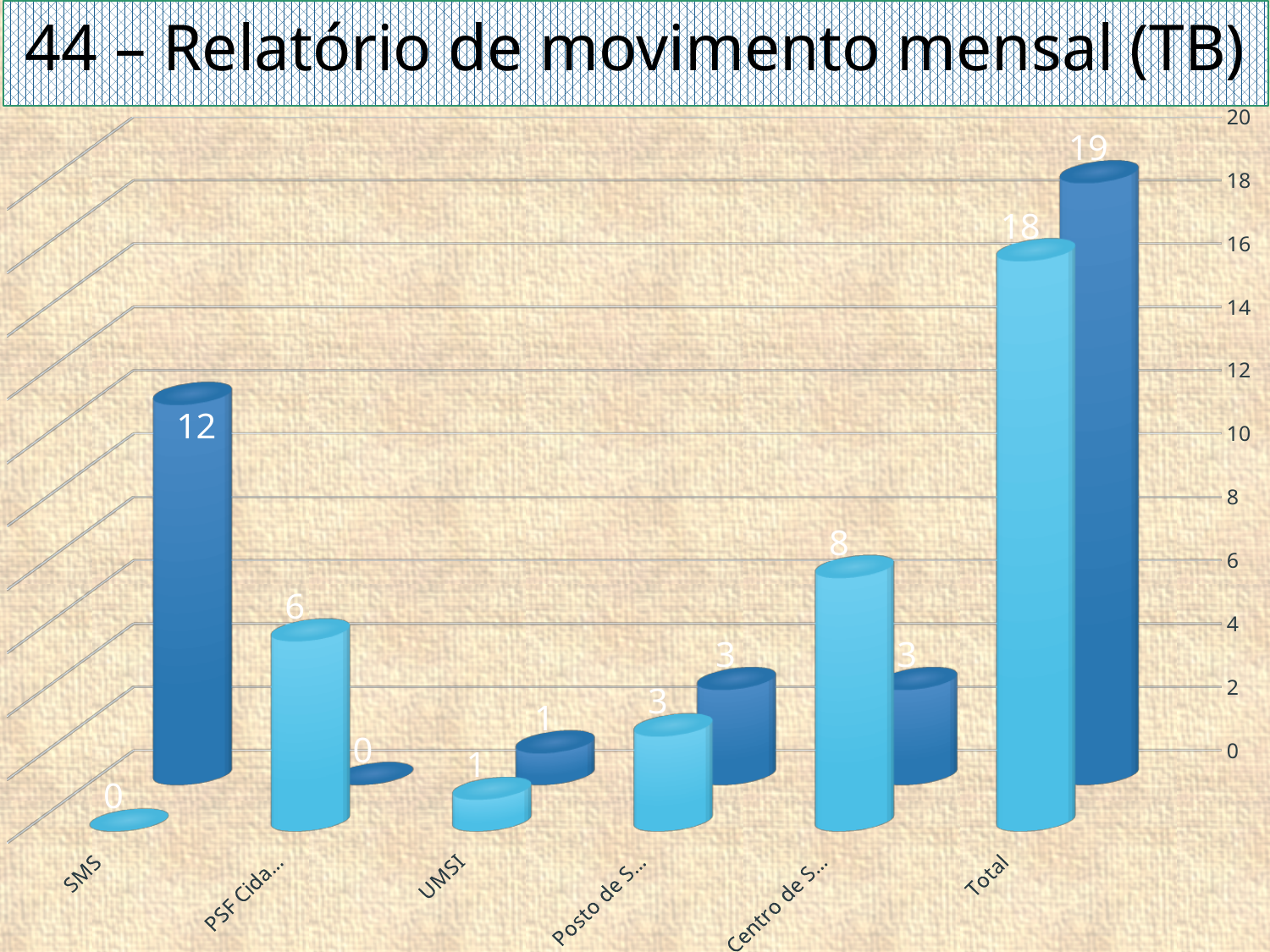
What is the value of the light blue bar for PSF Cida...? 6 How many categories are shown on the x axis of the chart? 6 What is the title of the slide? 44 – Relatório de movimento mensal (TB) Which is larger, the light blue bar for Centro de S... or the dark blue bar for Centro de S...? the light blue bar What is the value of the light blue bar for Centro de S...? 8 What is the difference between the dark blue bar for Total and the light blue bar for Total? 1 What is the difference between the dark blue bar for SMS and the light blue bar for SMS? 12 What is the value of the dark blue bar for SMS? 12 What is the value of the light blue bar for Total? 18 What is the value of the dark blue bar for Total? 19 Which category has the highest light blue bar? Total What kind of chart is shown on the slide? bar chart